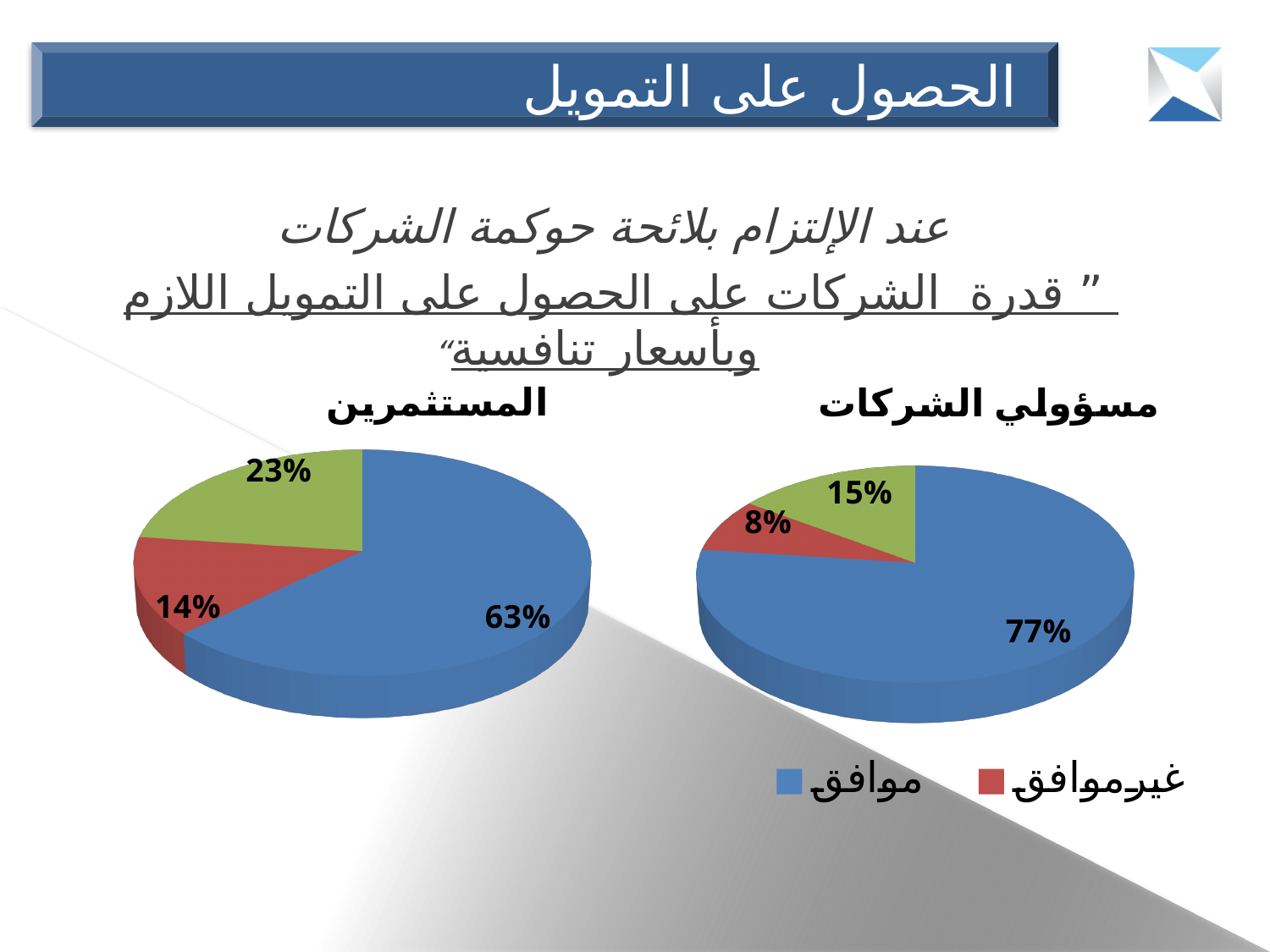
Which pie chart has the larger غير موافق share, المستثمرين or مسؤولي الشركات? المستثمرين What kind of charts are shown on the slide? Pie charts In the مسؤولي الشركات pie chart, what share does the موافق (blue) slice have? 77% How many slices does each pie chart have? 3 In the مسؤولي الشركات pie chart, which slice is the largest? موافق In the المستثمرين pie chart, what share does the green slice have? 23% In the مسؤولي الشركات pie chart, what share does the غير موافق (red) slice have? 8% What is the difference between the موافق share in the مسؤولي الشركات pie chart and the موافق share in the المستثمرين pie chart? 14% In the المستثمرين pie chart, what share does the غير موافق (red) slice have? 14% In the مسؤولي الشركات pie chart, what share does the green slice have? 15% In the المستثمرين pie chart, what share does the موافق (blue) slice have? 63% In the المستثمرين pie chart, which slice is the smallest? غير موافق